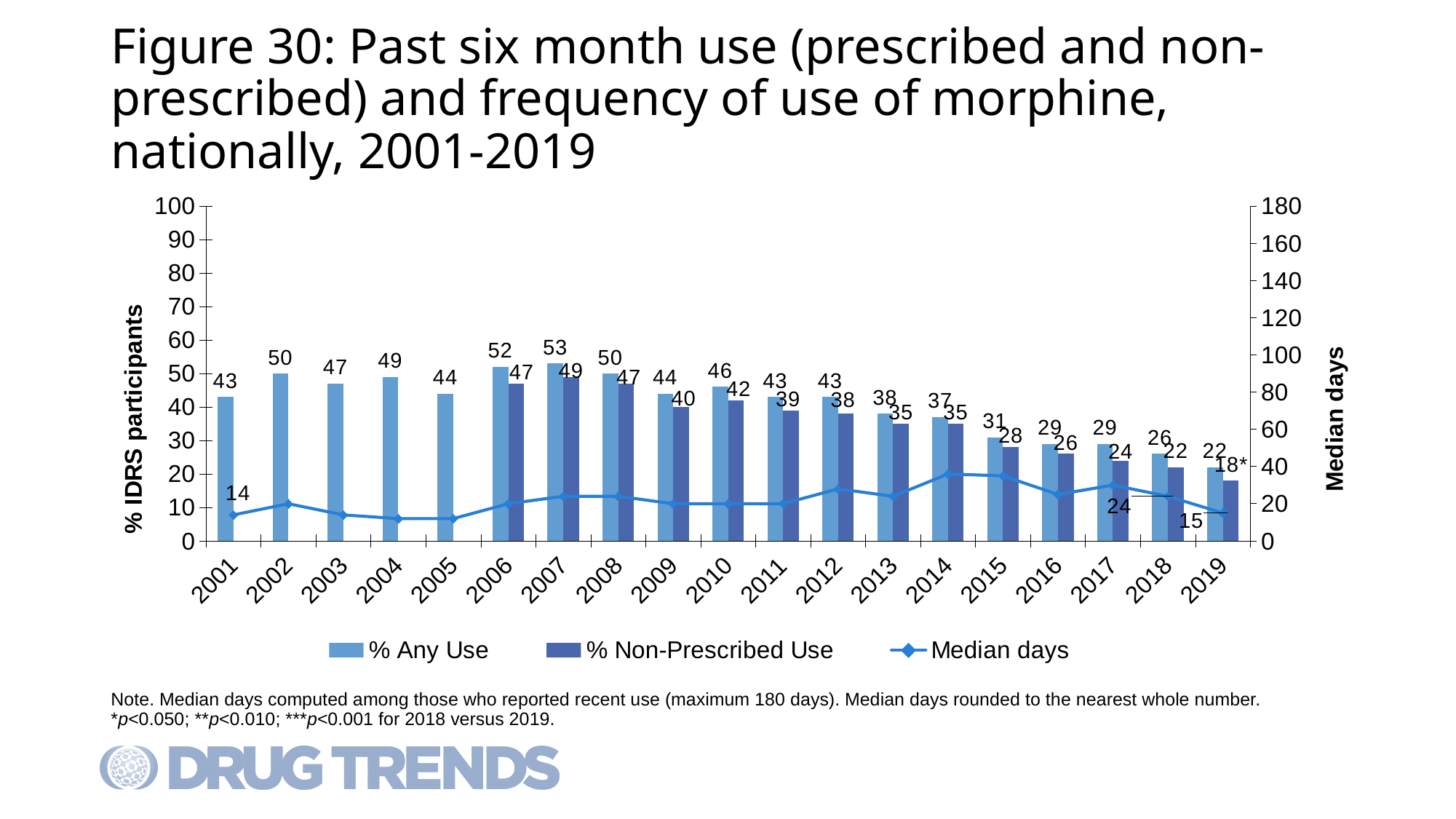
How many series does the legend list? 3 What is the % Non-Prescribed Use value for 2010? 42 Which year has the lowest % Any Use? 2019 What kind of chart is this? Bar and line chart What is the Median days value for 2001? 14 Is the Median days value for 2014 greater or less than 20? greater Which year has the highest % Any Use? 2007 How many years are shown on the x axis? 19 What is the % Any Use value for 2007? 53 Which year has the larger % Any Use, 2013 or 2015? 2013 What is the difference between % Any Use and % Non-Prescribed Use in 2007? 4